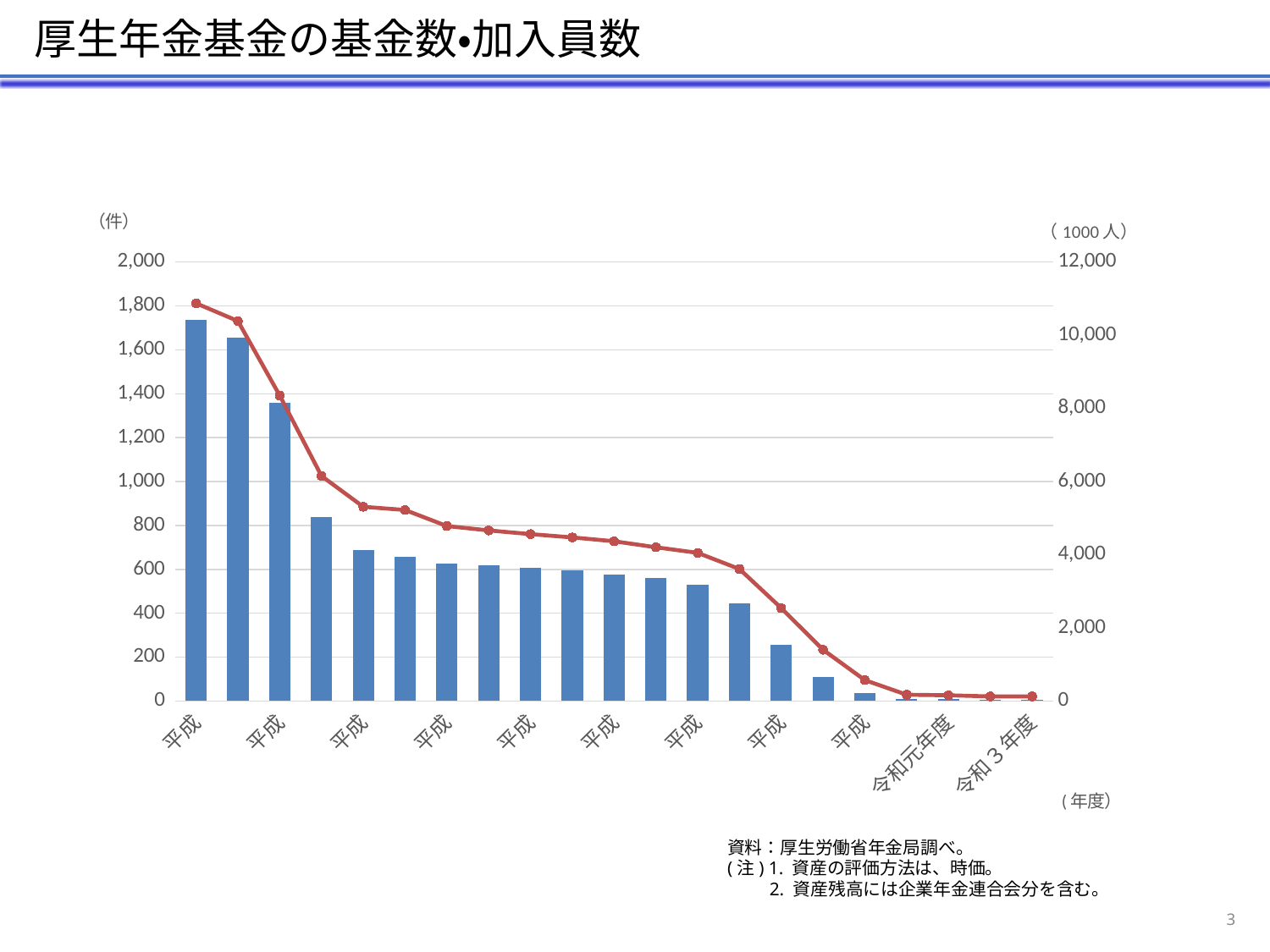
Do the bar values rise or fall from left to right along the x axis? Fall Does the red line rise or fall from left to right along the x axis? Fall What unit is shown on the left vertical axis of the chart? 件 Is the red line value for 令和元年度 greater or less than 2,000 on the right axis? less What kind of chart is shown on the slide? A combination bar and line chart What is the title of the chart on the slide? 厚生年金基金の基金数•加入員数 Which category has the highest bar in the chart? The leftmost 平成 category Is the value of the leftmost bar greater or less than 1,600 on the left axis? greater Which bar is larger, the leftmost bar or the bar for 令和元年度? The leftmost bar Is the value of the leftmost point on the red line greater or less than 10,000 on the right axis? greater How many data points does the red line have? 21